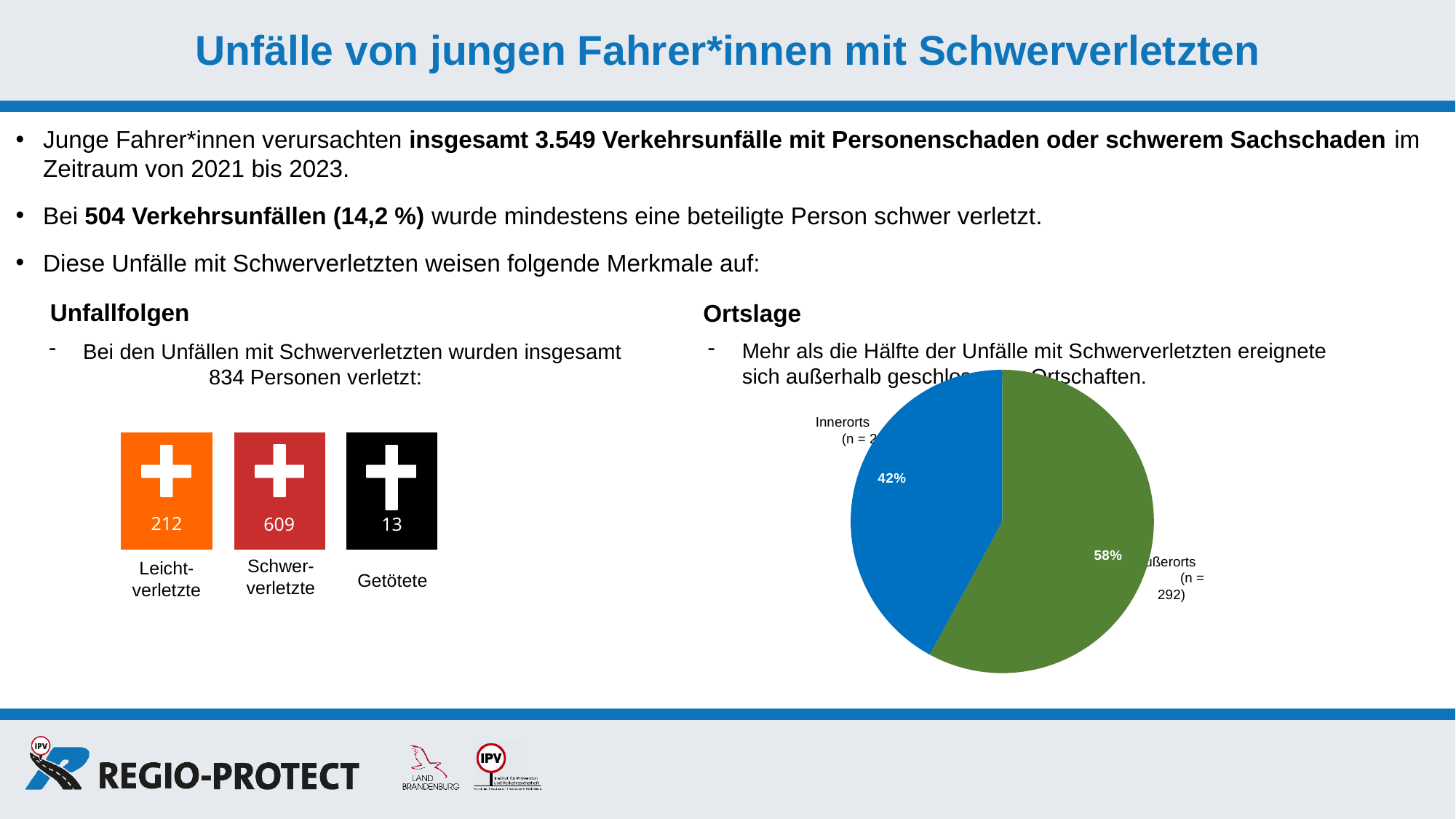
By how many percentage points does the Außerorts share exceed the Innerorts share? 16 percentage points Which slice of the pie chart is the smallest? Innerorts Which is larger in the pie chart, Innerorts or Außerorts? Außerorts How many slices does the pie chart have? 2 What is the n value given for Außerorts in the pie chart? 292 What share of the pie does the Außerorts slice represent? 58% What colour is the Außerorts slice in the pie chart? green What kind of chart is shown on the slide? pie chart What colour is the Innerorts slice in the pie chart? blue Is the Innerorts share greater or less than 50%? less What share of the pie does the Innerorts slice represent? 42% Which slice of the pie chart is the largest? Außerorts